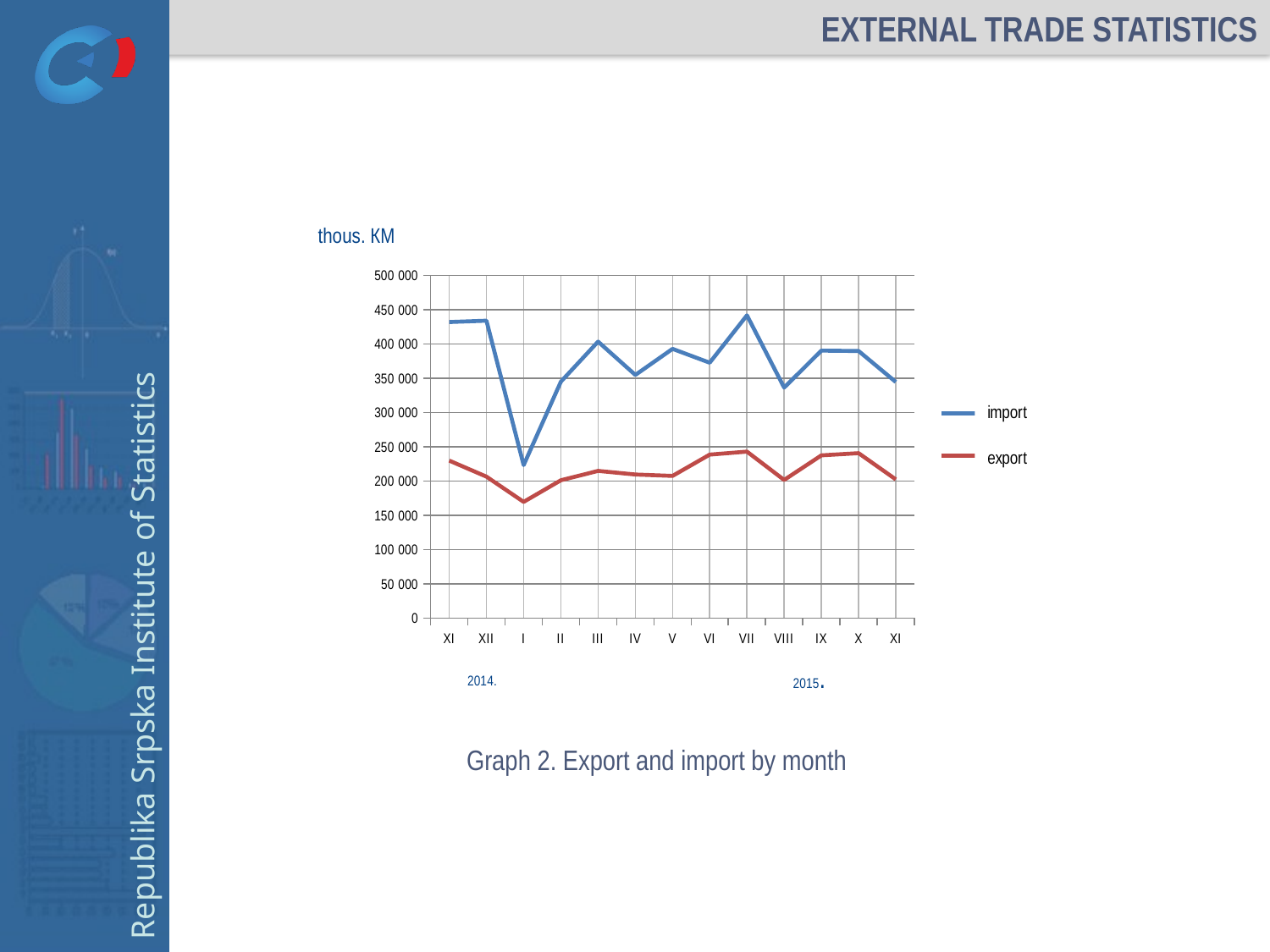
How many months are plotted along the x axis? 13 Is the export value for month I (2015) greater or less than 200 000? less What kind of chart is shown on the slide? line chart How many series does the legend list? 2 In which month is the import value lowest? I (2015) Which colour is used for the export line? red In which month is the import value highest? VII (2015) Which is larger in month XI 2014, import or export? import Is the import value for month I (2015) greater or less than 250 000? less Is the import value for month VII (2015) greater or less than 400 000? greater Does the import value rise or fall from month XII (2014) to month I (2015)? fall In which month is the export value lowest? I (2015)